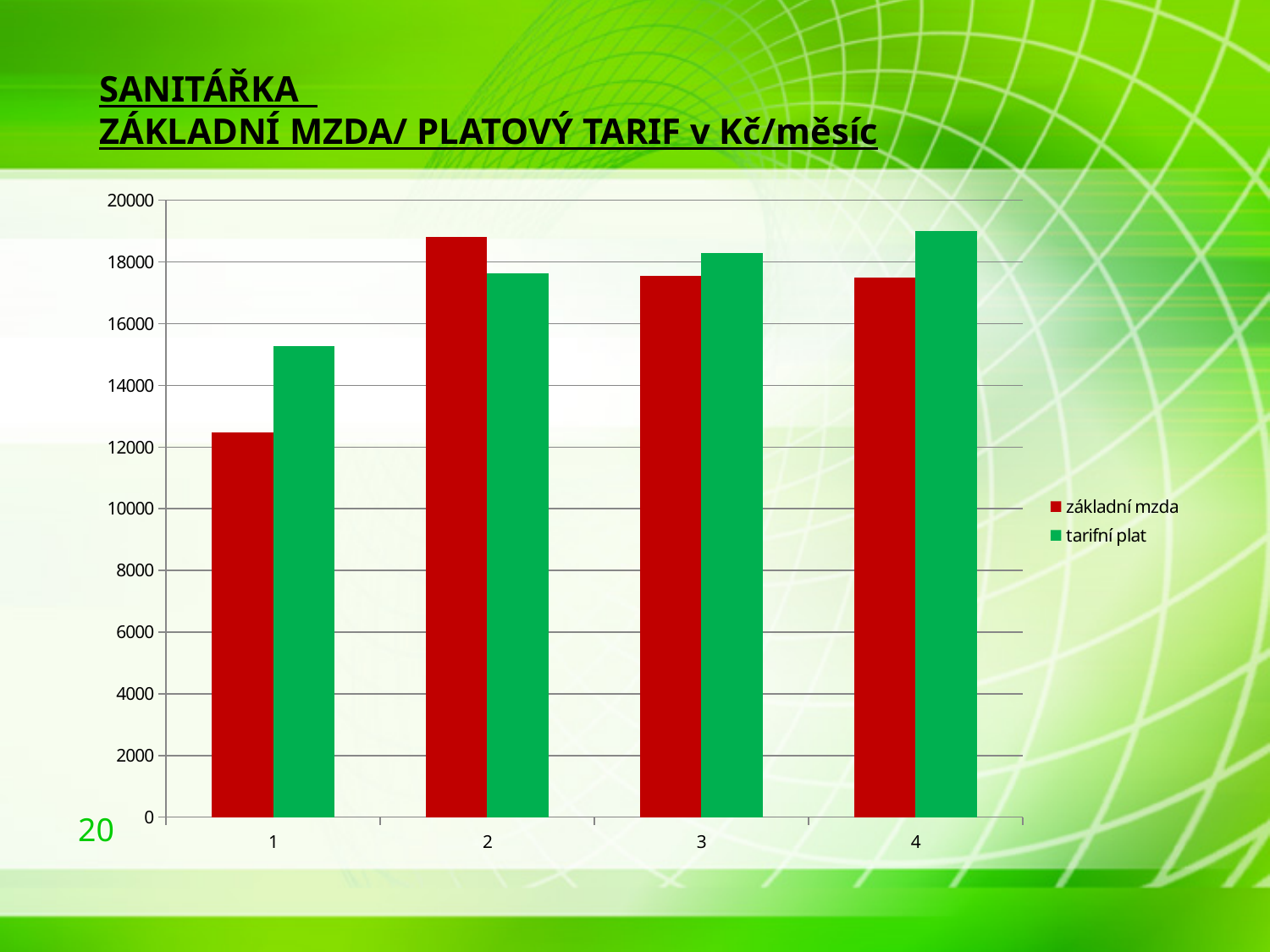
Which category has the highest tarifní plat? 4 Which category has the highest základní mzda? 2 For category 1, which is larger: základní mzda or tarifní plat? tarifní plat How many categories are shown on the x axis of the chart? 4 Do the tarifní plat values rise or fall from category 1 to category 4? rise How many series does the legend list? 2 Is the základní mzda value for category 1 greater or less than 14000? less What kind of chart is shown on the slide? bar chart Is the tarifní plat value for category 4 greater or less than 18000? greater Which series is shown in red in the chart? základní mzda For category 2, which is larger: základní mzda or tarifní plat? základní mzda Which category has the lowest tarifní plat? 1